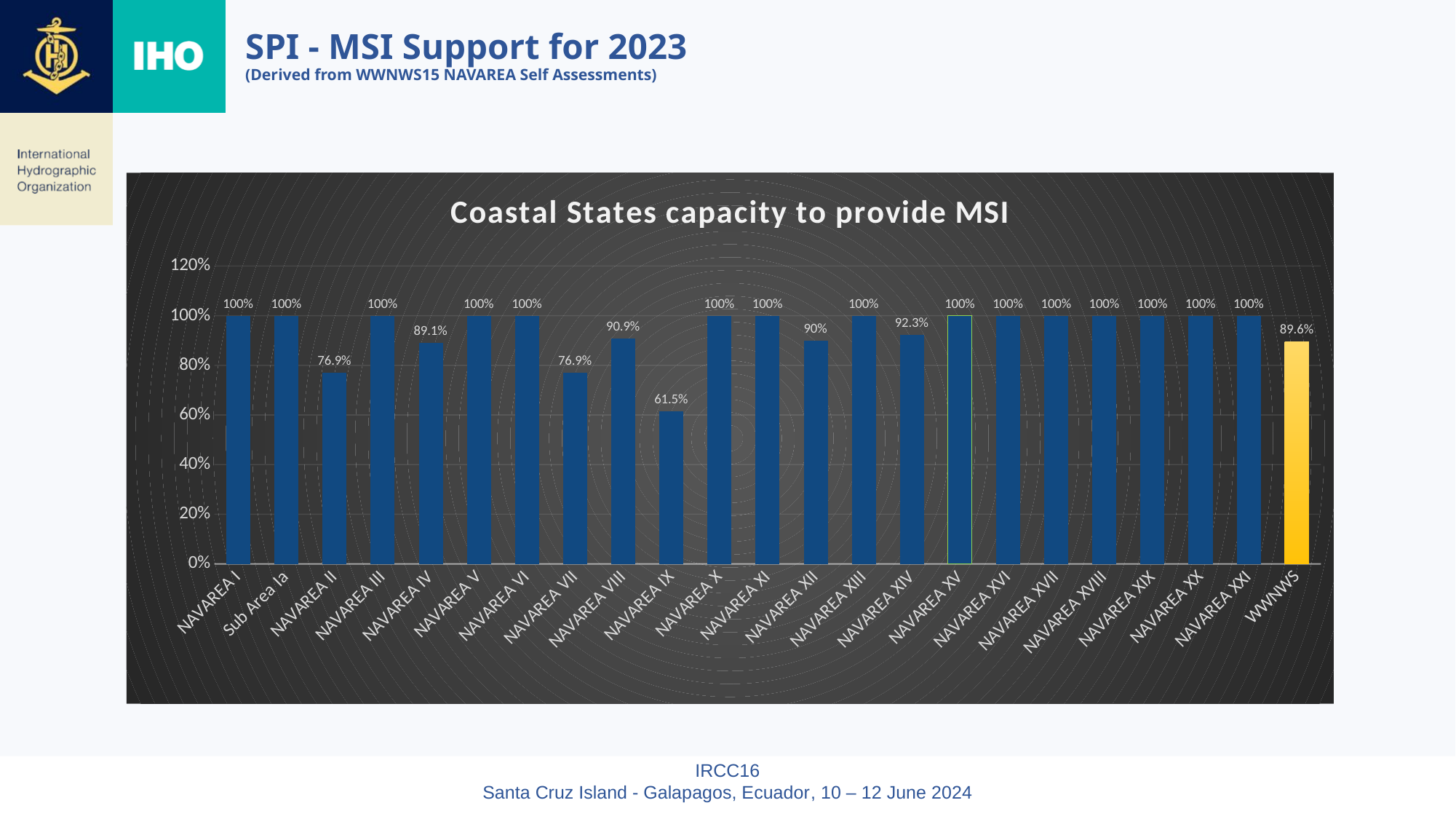
How many categories are shown on the x axis? 23 What is the value for NAVAREA IX? 61.5% Which is larger, the value for NAVAREA VIII or the value for NAVAREA VII? NAVAREA VIII What is the value for NAVAREA XIV? 92.3% What is the title of the chart? Coastal States capacity to provide MSI What is the difference between the values for NAVAREA II and NAVAREA IX? 15.4% Is the value for NAVAREA IX greater or less than 80%? less Which category has the lowest value? NAVAREA IX What is the difference between the values for NAVAREA XIV and NAVAREA XII? 2.3% What kind of chart is shown? bar chart What is the value for NAVAREA IV? 89.1% What is the value for WWNWS? 89.6%